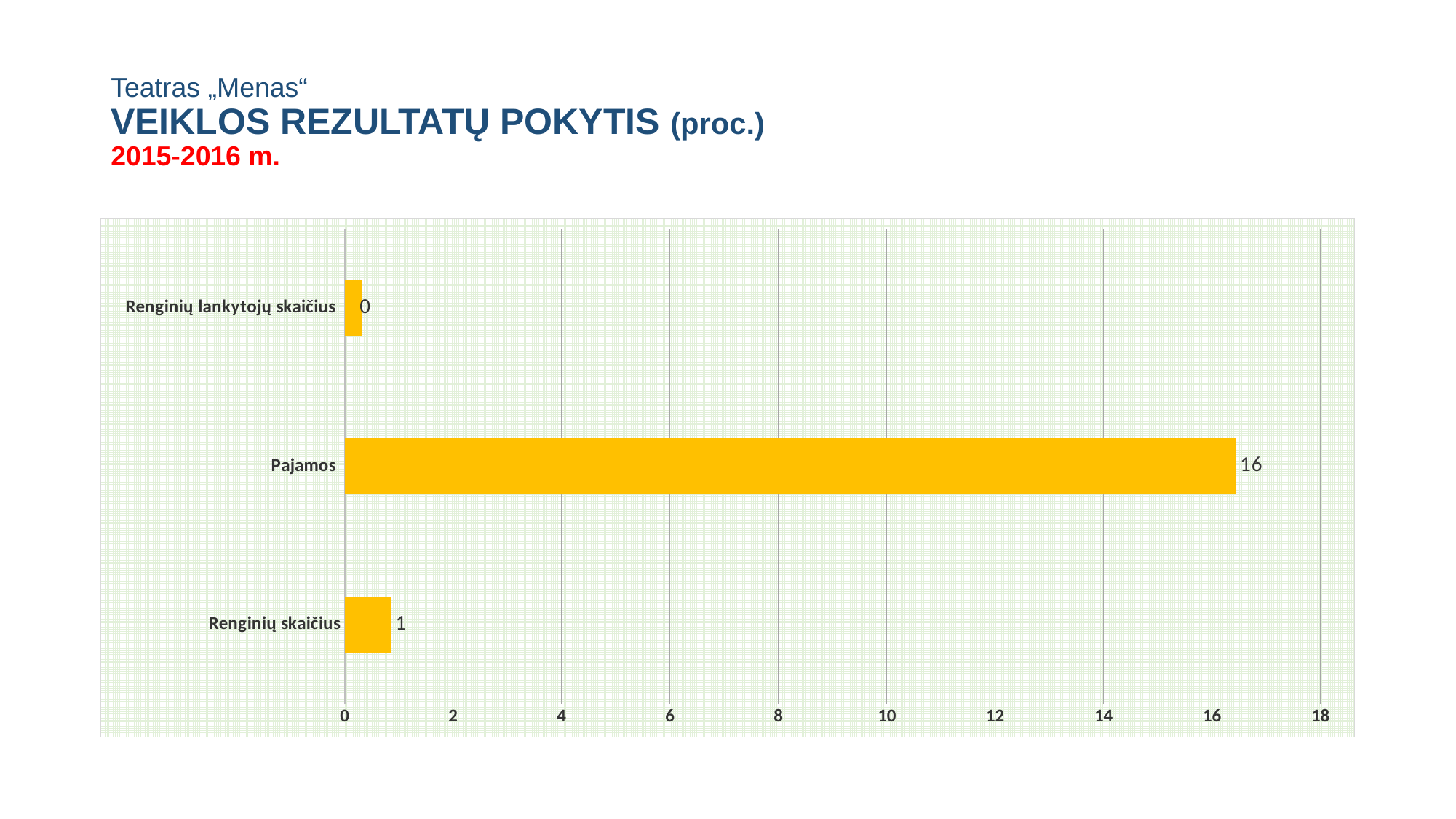
Which category has the highest value? Pajamos What is the value for Pajamos? 16 What kind of chart is shown on the slide? bar chart What is the difference between the values for Pajamos and Renginių skaičius? 15 What is the value for Renginių skaičius? 1 What is the highest value shown on the horizontal axis? 18 What colour are the bars in the chart? yellow Is the value for Pajamos greater or less than 10? greater How many categories are shown in the chart? 3 Which is larger, the value for Pajamos or the value for Renginių skaičius? Pajamos Which category has the lowest value? Renginių lankytojų skaičius What is the value for Renginių lankytojų skaičius? 0